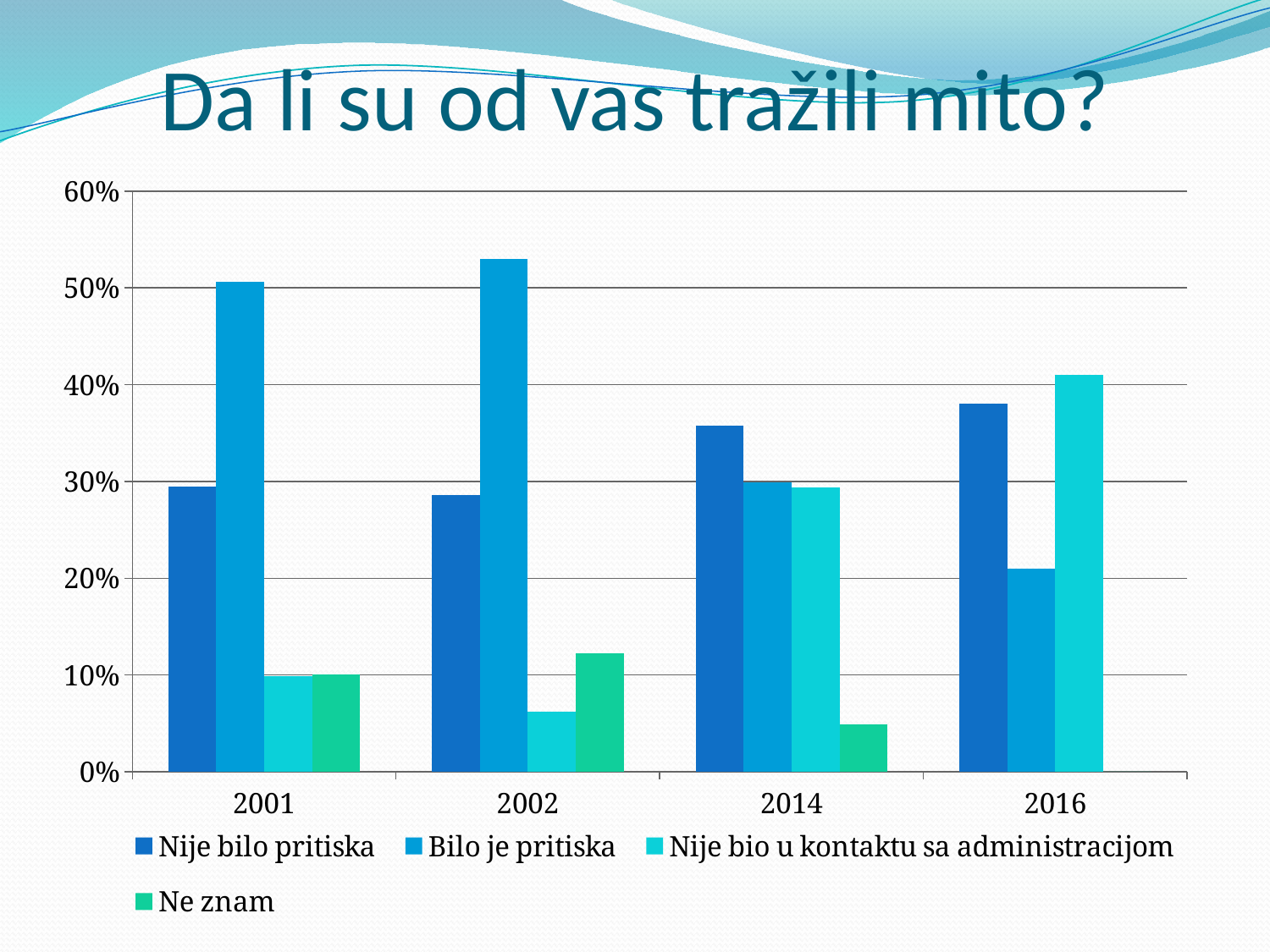
In which year is the value for 'Bilo je pritiska' the highest? 2002 Is the value for 'Ne znam' in 2014 greater or less than 10%? less What kind of chart is shown on the slide? bar chart How many years are shown on the x axis? 4 Which series has the lowest value in 2014? Ne znam What is the title of the chart? Da li su od vas tražili mito? How many series does the legend list? 4 In 2016, which is larger: 'Nije bio u kontaktu sa administracijom' or 'Nije bilo pritiska'? Nije bio u kontaktu sa administracijom Is the value for 'Nije bilo pritiska' in 2016 greater or less than 30%? greater Which series has the highest value in 2001? Bilo je pritiska Does the value for 'Bilo je pritiska' rise or fall from 2002 to 2016? fall Is the value for 'Bilo je pritiska' in 2001 greater or less than 40%? greater